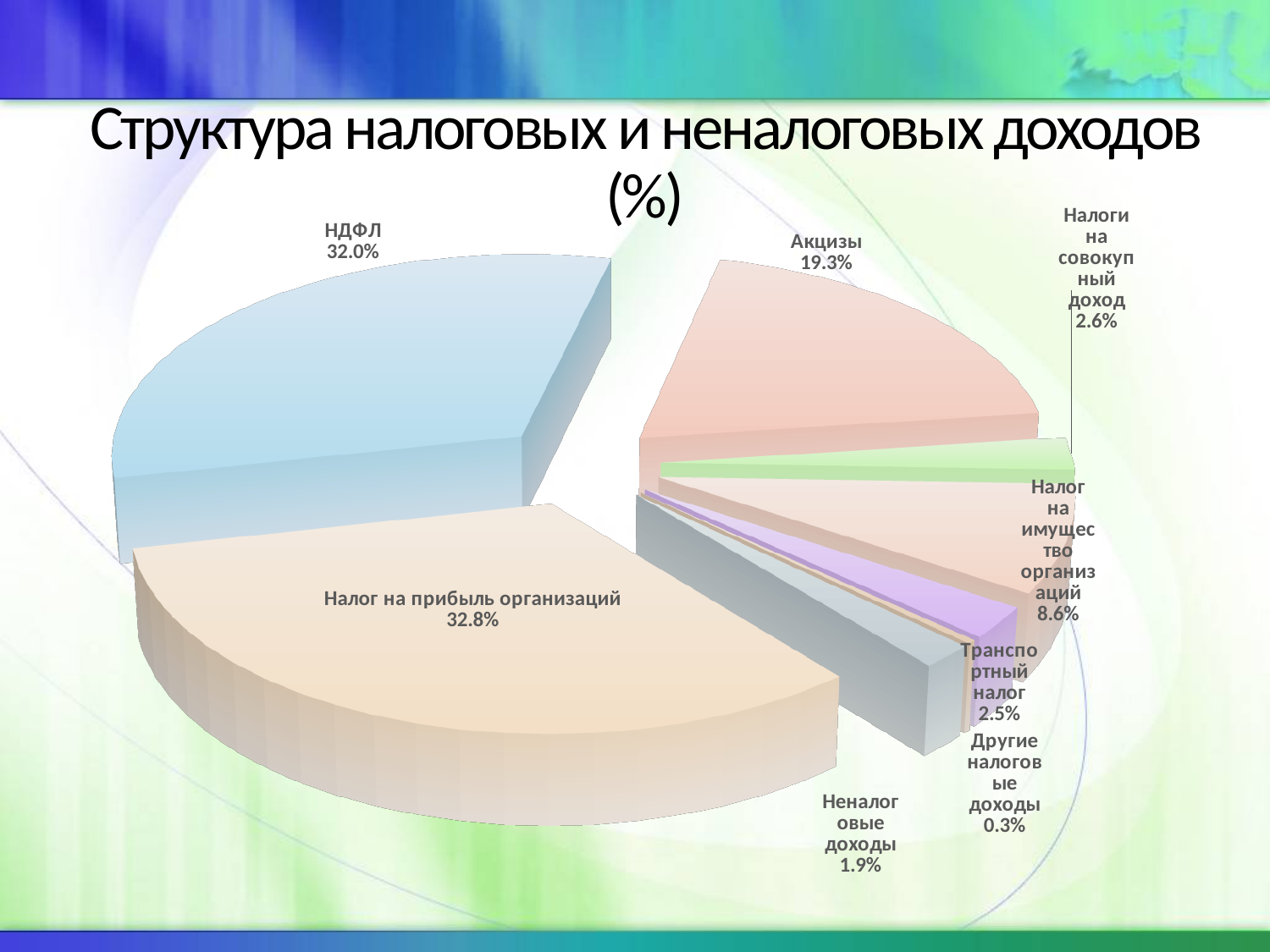
What is the share of НДФЛ in the pie chart? 32.0% What is the value shown for Налог на имущество организаций? 8.6% Which is larger: the share of Налоги на совокупный доход or the share of Транспортный налог? Налоги на совокупный доход Which category has the smallest share in the pie chart? Другие налоговые доходы How many categories are shown in the pie chart? 8 What is the difference between the shares of Акцизы and Налог на имущество организаций? 10.7% What is the value shown for Неналоговые доходы? 1.9% Which category has the largest share in the pie chart? Налог на прибыль организаций What is the value shown for Акцизы? 19.3% What is the title of the chart on the slide? Структура налоговых и неналоговых доходов (%) What type of chart is shown on the slide? Pie chart What is the difference between the shares of Налог на прибыль организаций and НДФЛ? 0.8%